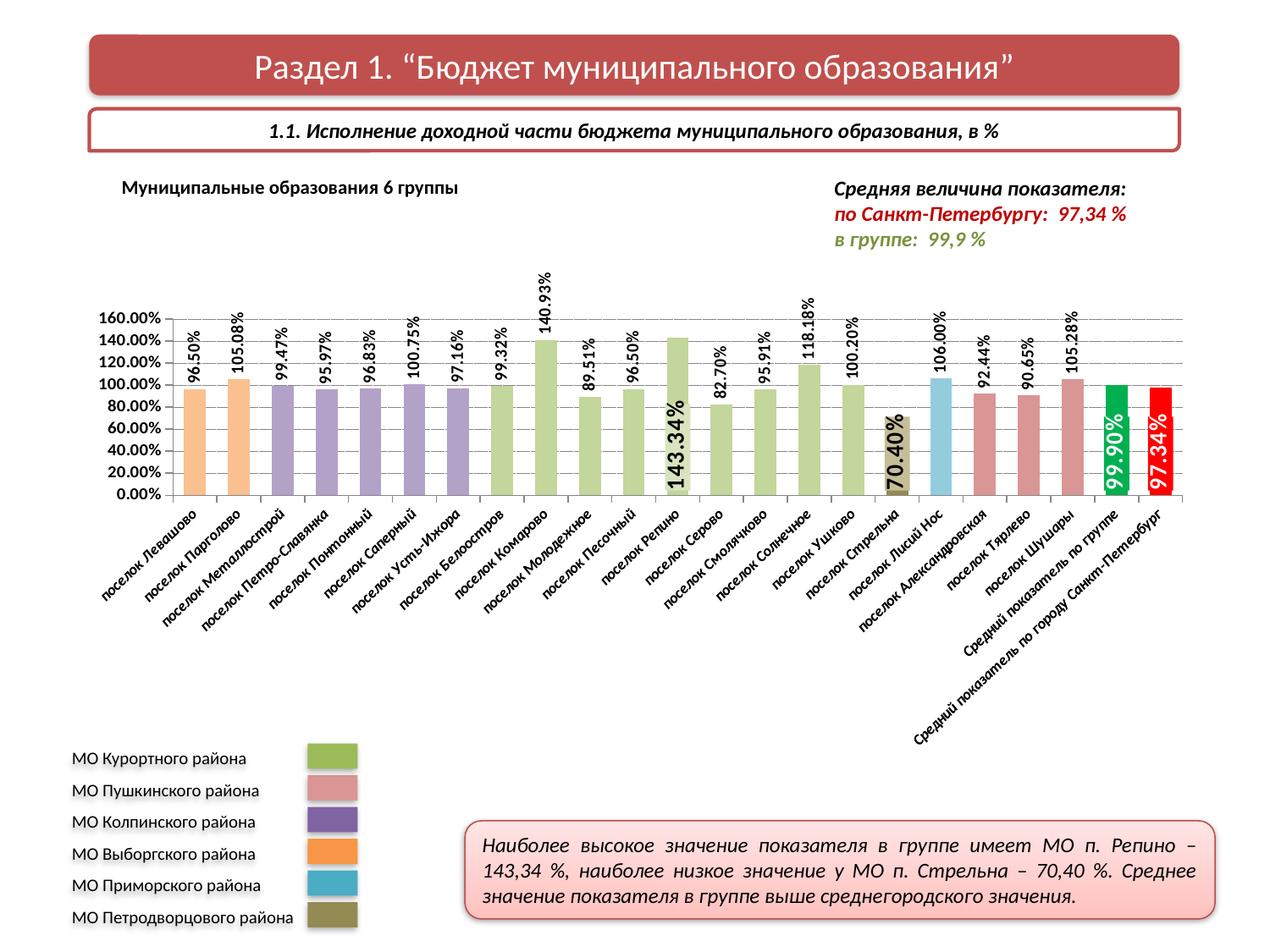
What is the value shown for Средний показатель по группе? 99.90% How many bars are plotted in the chart? 23 What is the difference between the values for поселок Репино and поселок Стрельна? 72.94% What is the value for поселок Стрельна? 70.40% Which is larger, the value for поселок Парголово or поселок Шушары? поселок Шушары Which category has the highest value? поселок Репино What is the value for поселок Комарово? 140.93% What colour in the legend represents МО Приморского района? Blue Is the value for поселок Серово greater or less than 100.00%? less What is the difference between the values for поселок Комарово and поселок Солнечное? 22.75% Which category has the lowest value? поселок Стрельна What is the value for поселок Лисий Нос? 106.00%